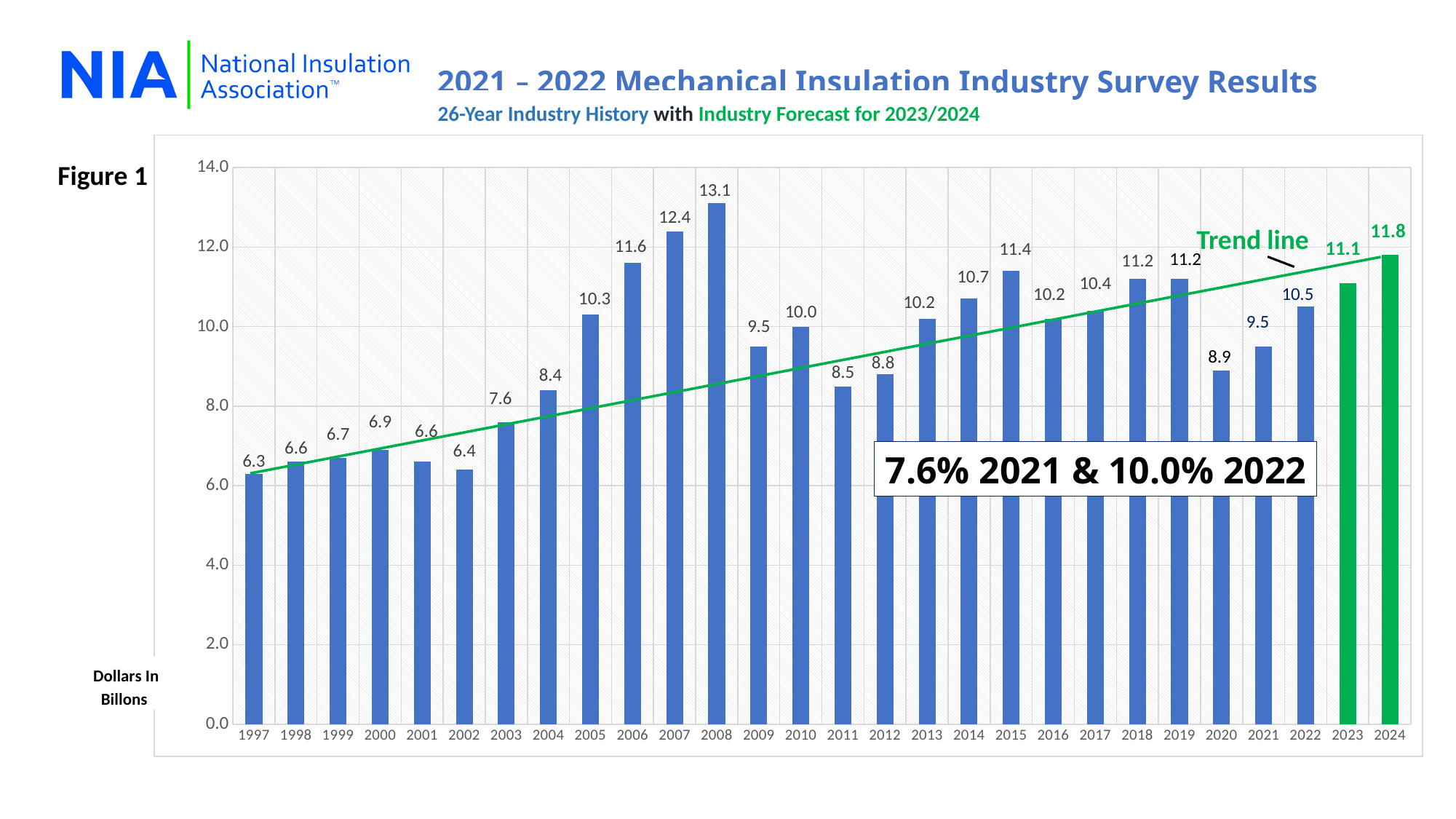
What colour are the bars for the forecast years 2023 and 2024? green Do the values rise or fall from 2008 to 2011? fall How many years are shown on the x axis? 28 What is the value for 2008? 13.1 Which year has the highest value? 2008 What unit is given for the values on the chart? Dollars In Billons Which year has the lowest value? 1997 What is the difference between the 2022 value and the 2021 value? 1.0 What is the forecast value for 2024? 11.8 Which is larger, the value for 2007 or the value for 2015? 2007 What is the value for 2020? 8.9 What kind of chart is this? bar chart